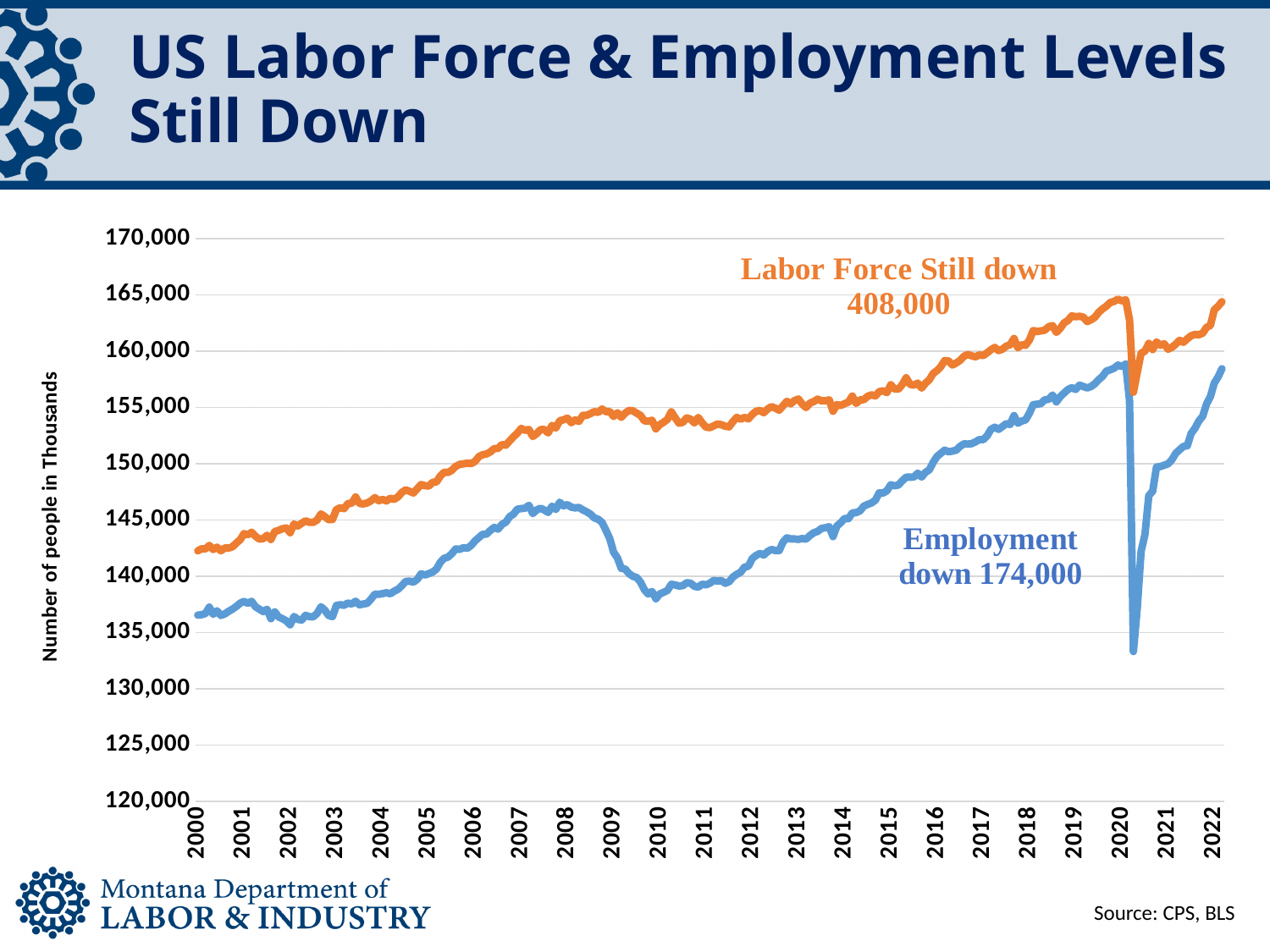
What is the label on the vertical axis of the chart? Number of people in Thousands According to the annotation on the chart, by how much is the Labor Force still down? 408,000 Is the Labor Force value in 2022 greater or less than 160,000? greater Is the lowest point of the Employment line, in 2020, greater or less than 135,000? less According to the annotation on the chart, by how much is Employment down? 174,000 Is the Employment value in 2022 greater or less than 160,000? less What kind of chart is shown on the slide? line chart Which series is plotted higher on the chart throughout the period, Labor Force or Employment? Labor Force How many data series are plotted on the chart? 2 Does the Labor Force line generally rise or fall from 2000 to 2019? rise